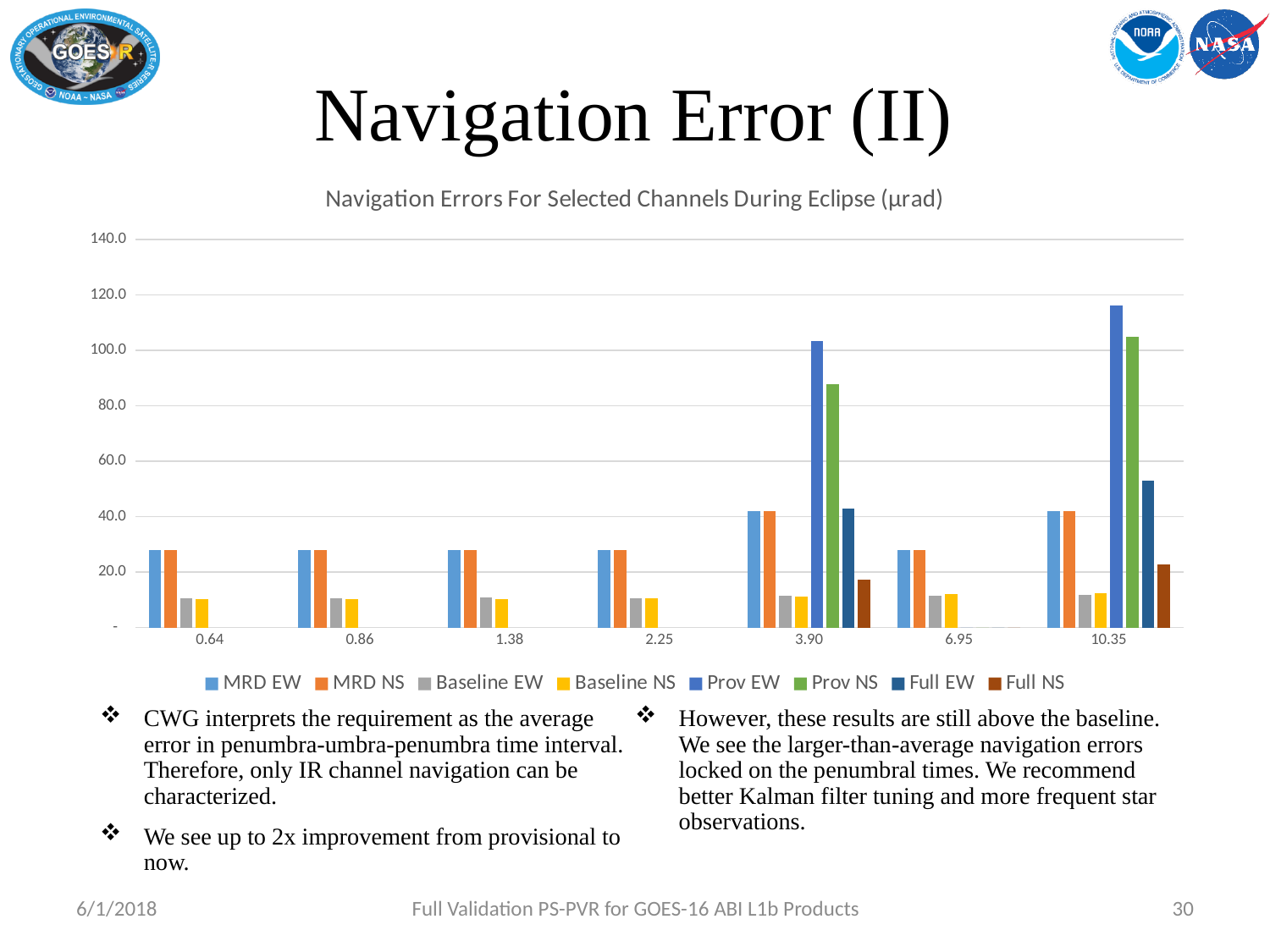
At 10.35, which is larger, Full EW or Full NS? Full EW Which category has the highest Prov EW value? 10.35 Is the value for Prov EW at 10.35 greater or less than 100? greater Which series is shown in green in the legend? Prov NS Is the value for Baseline EW at 0.64 greater or less than 20? less At 3.90, which is larger, Prov EW or Prov NS? Prov EW Is the value for Prov NS at 3.90 greater or less than 100? less What kind of chart is shown on the slide? bar chart How many categories are shown along the x axis of the chart? 7 What is the title of the chart? Navigation Errors For Selected Channels During Eclipse (µrad) How many series does the chart legend list? 8